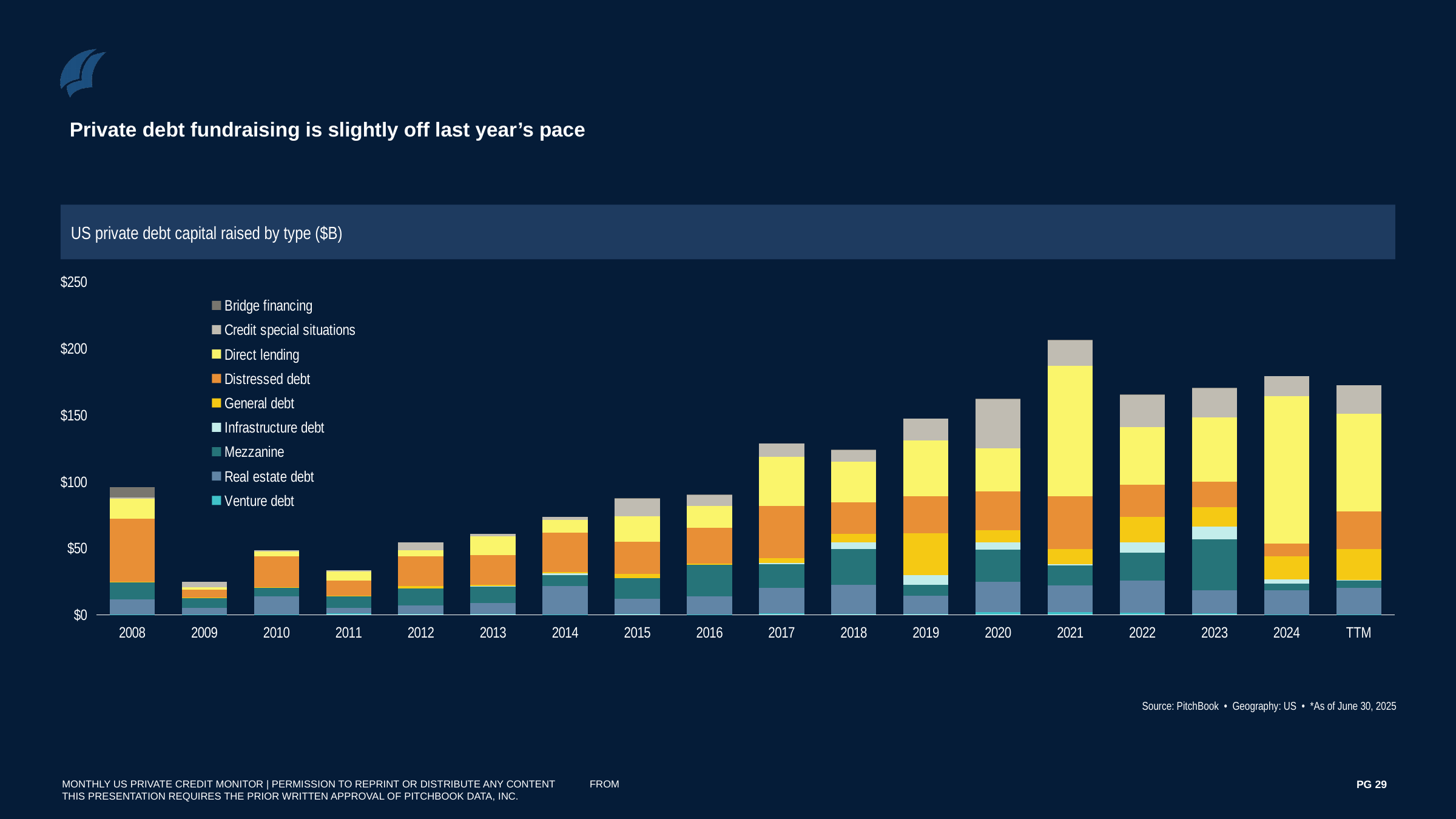
Which has a larger total, 2021 or 2022? 2021 Is the total value for 2009 greater or less than $50? less Which year has the lowest total private debt capital raised? 2009 How many categories are shown along the x axis? 18 What kind of chart is shown on the slide? Stacked bar chart Do the total bar heights generally rise or fall from 2009 to 2021? Rise Is the total value for 2024 greater or less than $150? greater Which year has the highest total private debt capital raised? 2021 Is the total value for 2014 greater or less than $100? less What is the title of the chart? US private debt capital raised by type ($B) How many series does the legend list? 9